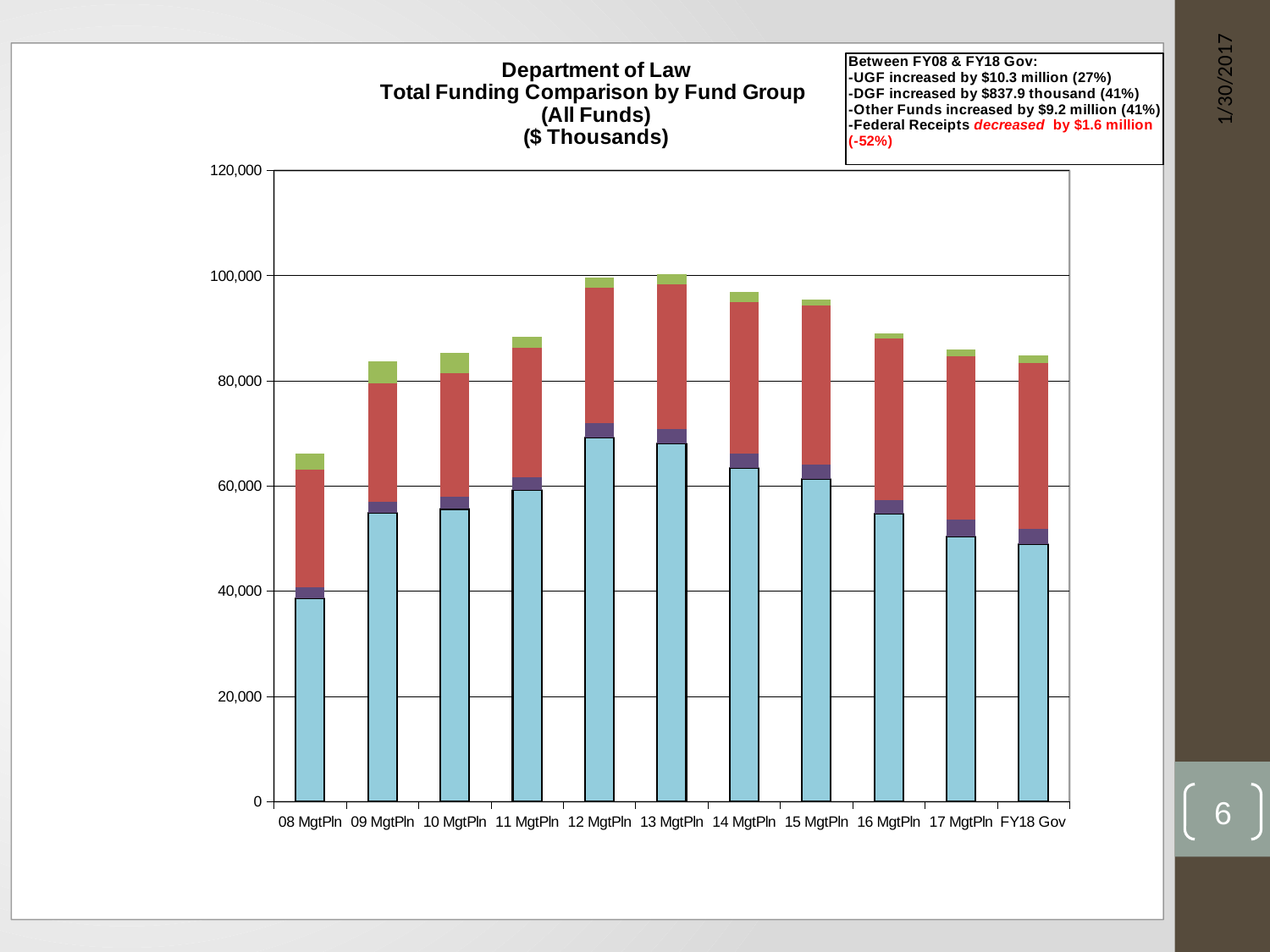
Which has the larger total funding, 08 MgtPln or 09 MgtPln? 09 MgtPln According to the text box, by how much did Federal Receipts change between FY08 and FY18 Gov? decreased by $1.6 million (-52%) Is the light blue (bottom) segment for FY18 Gov greater or less than 60,000? less Is the total funding for 12 MgtPln greater or less than 80,000? greater How many fiscal-year categories are shown along the x axis? 11 Is the total funding for 08 MgtPln greater or less than 80,000? less Do the total bar heights rise or fall from 13 MgtPln to FY18 Gov? fall Which category has the lowest total funding? 08 MgtPln Which has the larger total funding, 12 MgtPln or FY18 Gov? 12 MgtPln What kind of chart is shown on the slide? Stacked bar chart